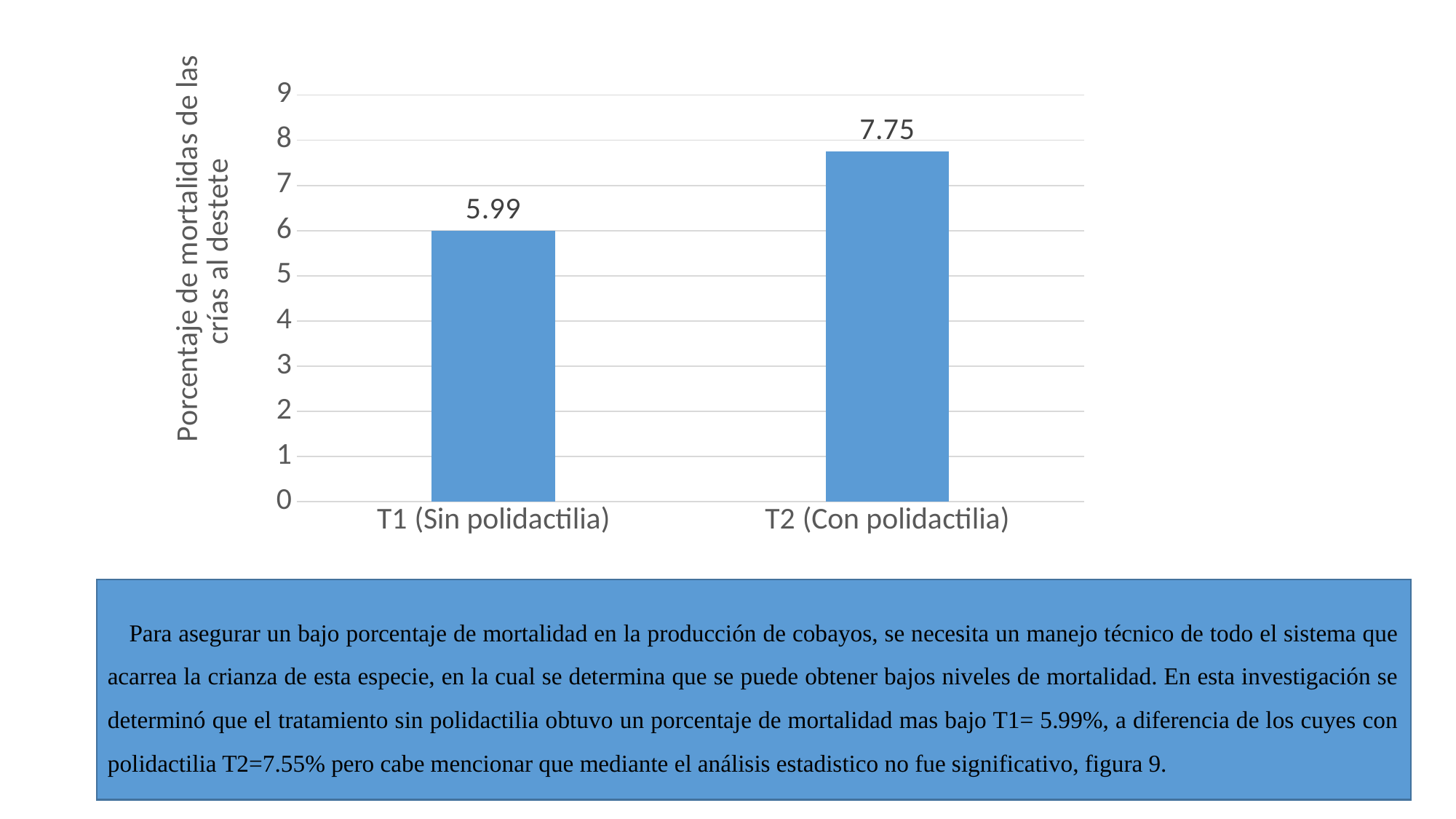
Do the values rise or fall from T1 to T2 along the x axis? rise Is the value for T1 (Sin polidactilia) greater or less than 6? less Which is larger, the value for T1 (Sin polidactilia) or T2 (Con polidactilia)? T2 (Con polidactilia) Is the value for T2 (Con polidactilia) greater or less than 7? greater What is the difference between the values for T2 (Con polidactilia) and T1 (Sin polidactilia)? 1.76 Which category has the highest value? T2 (Con polidactilia) What is the label of the vertical axis? Porcentaje de mortalidas de las crías al destete What is the value for T2 (Con polidactilia)? 7.75 What kind of chart is shown on the slide? bar chart How many categories are shown on the x axis? 2 What is the value for T1 (Sin polidactilia)? 5.99 Which category has the lowest value? T1 (Sin polidactilia)